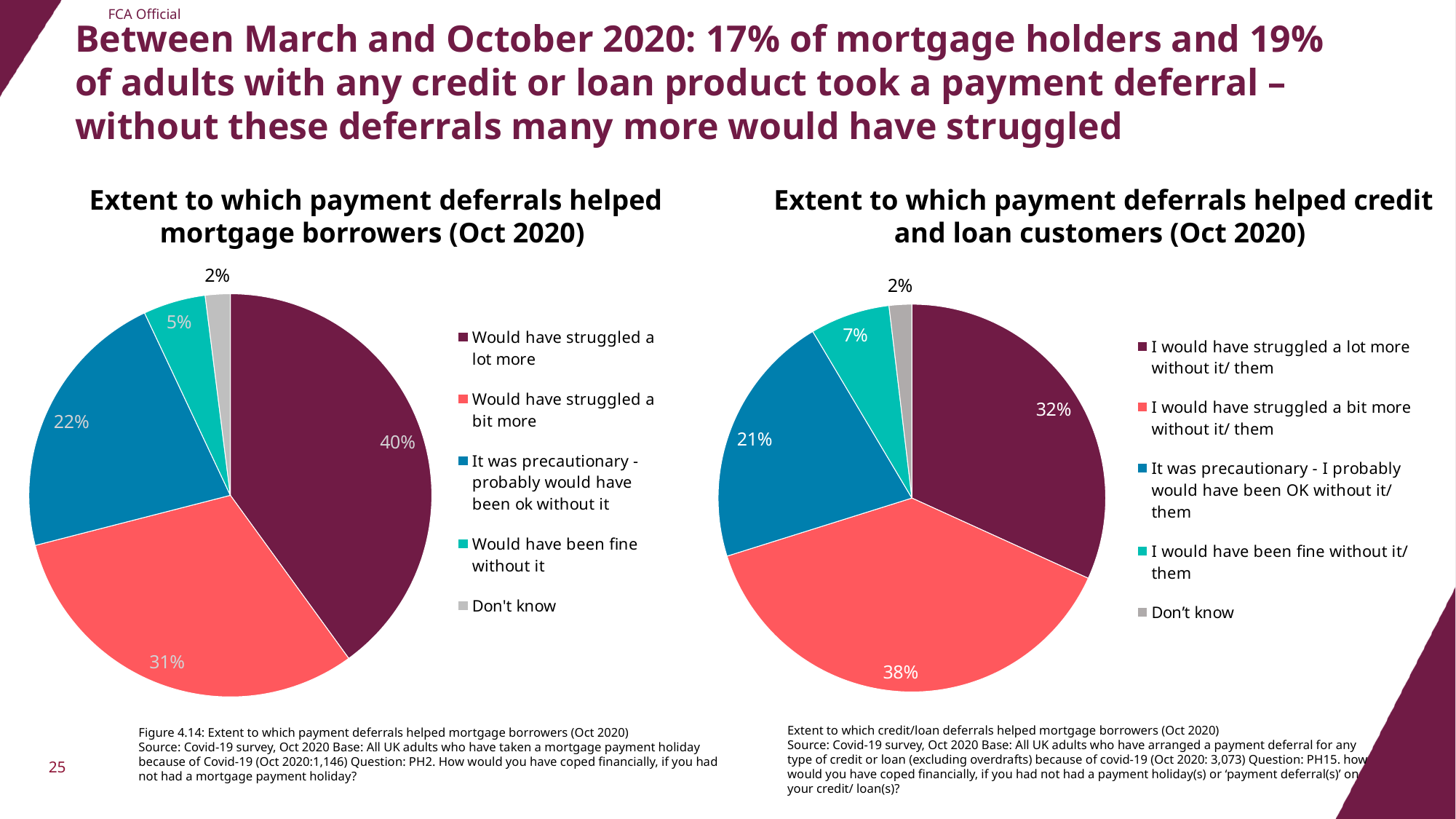
In the left chart (mortgage borrowers), which category has the smallest slice? Don't know In the right chart (credit and loan customers), what share said they would have been fine without it/them? 7% In the left chart (mortgage borrowers), what share of respondents said they would have struggled a lot more? 40% In the left chart (mortgage borrowers), which category has the largest slice? Would have struggled a lot more In the left chart (mortgage borrowers), what share said it was precautionary - probably would have been ok without it? 22% In the left chart (mortgage borrowers), what is the difference between the 'Would have struggled a lot more' and 'Would have struggled a bit more' shares? 9 percentage points How many categories does the legend of the right chart (credit and loan customers) list? 5 In the right chart (credit and loan customers), what is the difference between the 'struggled a bit more' and 'struggled a lot more' shares? 6 percentage points In the right chart (credit and loan customers), what share said they would have struggled a bit more without it/them? 38% Which is larger: the 'Would have been fine without it' share in the left chart or the 'I would have been fine without it/ them' share in the right chart? The right chart (7%) What type of chart is used on this slide? Pie chart In the right chart (credit and loan customers), which category has the largest slice? I would have struggled a bit more without it/ them